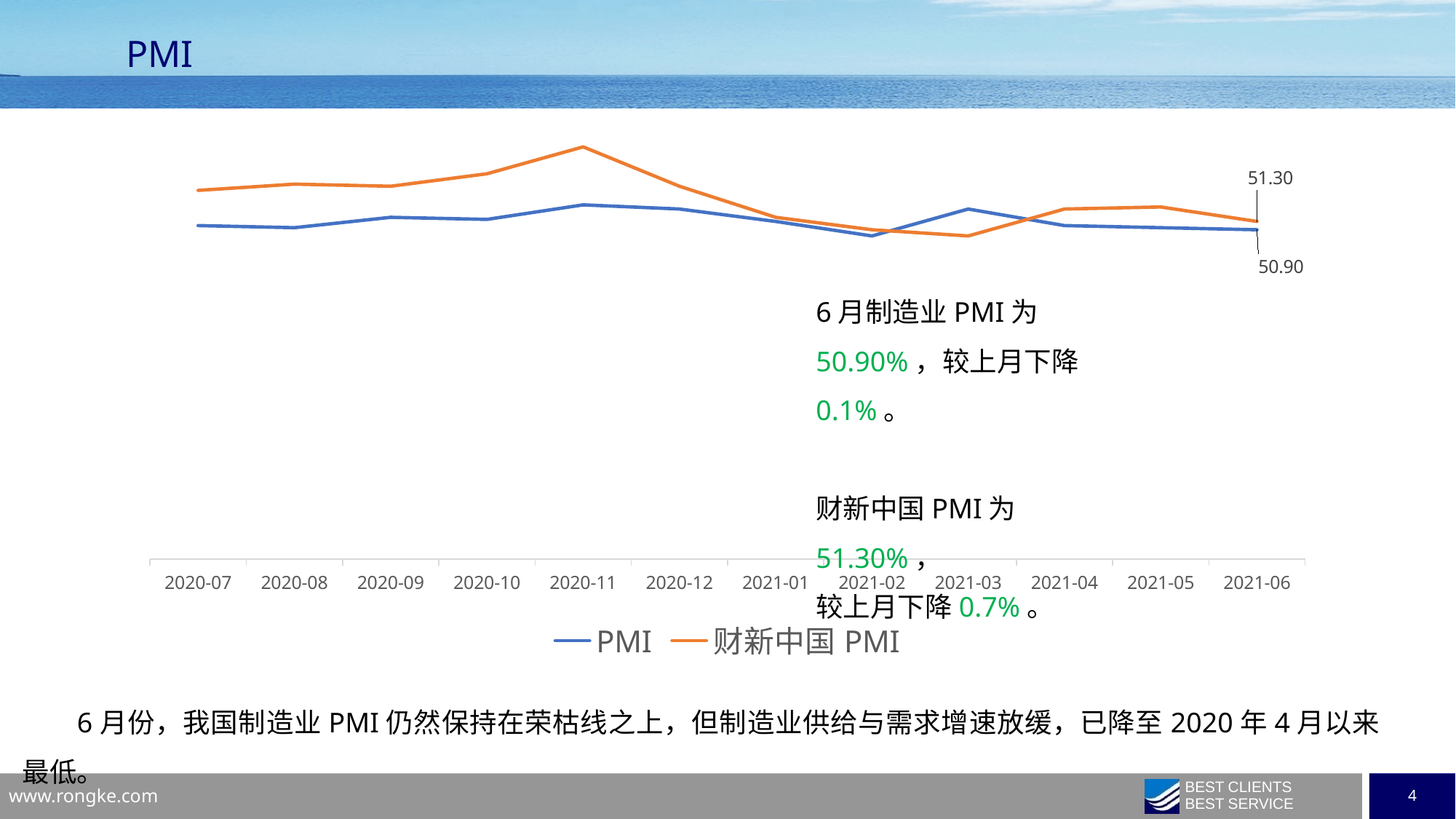
In which month does 财新中国 PMI reach its highest value? 2020-11 Does 财新中国 PMI rise or fall from 2020-11 to 2021-03? fall In 2021-06, which series has the larger value, PMI or 财新中国 PMI? 财新中国 PMI What is the first month shown on the x axis? 2020-07 In 2021-03, which series is higher, PMI or 财新中国 PMI? PMI What colour is the line for the PMI series? blue What kind of chart is shown on the slide? line chart What is the value of PMI for 2021-06? 50.90 How many months are shown on the x axis? 12 What is the value of 财新中国 PMI for 2021-06? 51.30 How many series does the legend list? 2 What is the difference between 财新中国 PMI and PMI in 2021-06? 0.40